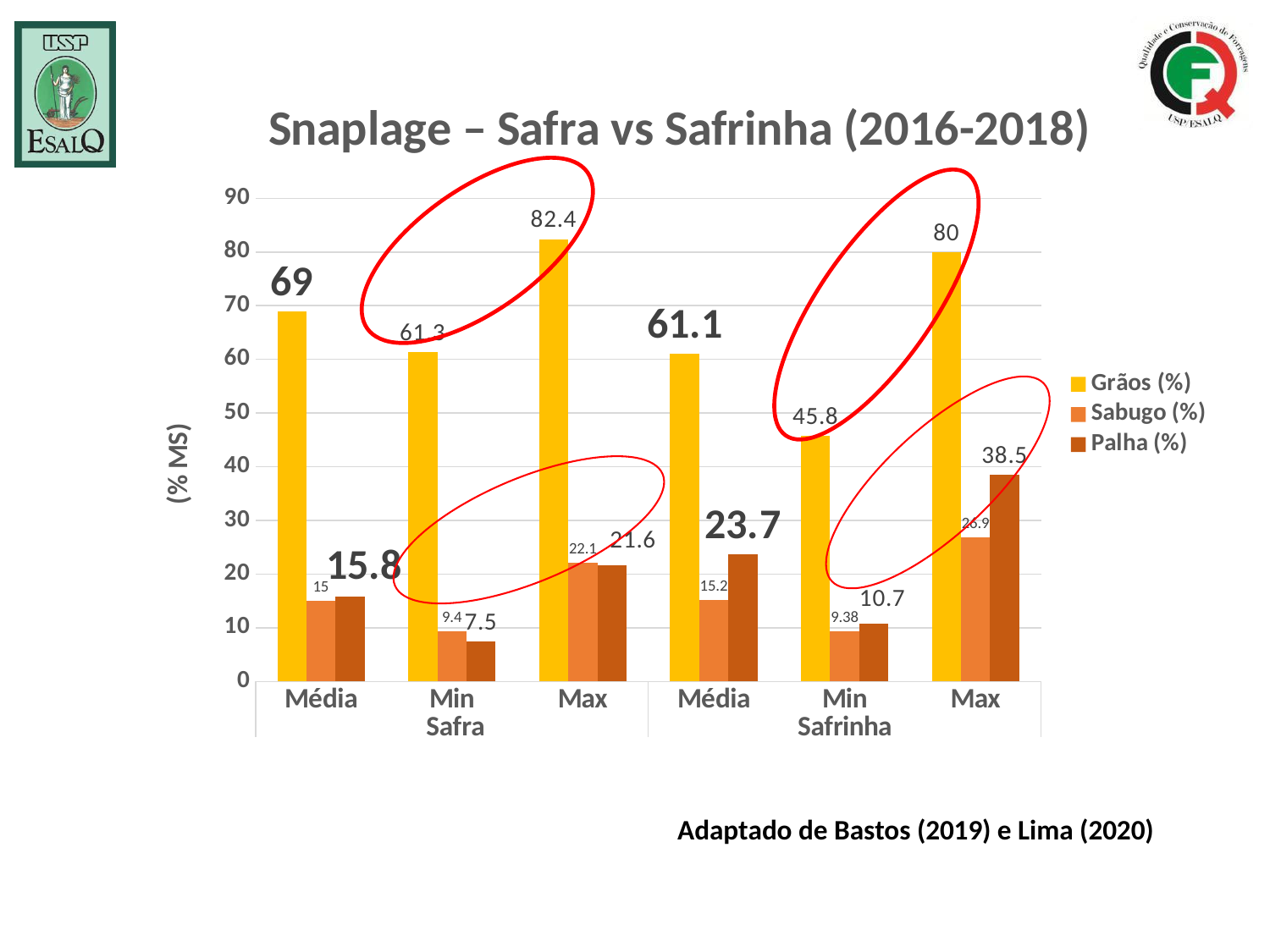
What kind of chart is shown on the slide? Bar chart What is the Sabugo (%) value for Min in Safrinha? 9.38 How many series does the legend list? 3 Which category has the lowest Palha (%) value? Min (Safra) What is the label on the vertical axis? (% MS) What is the Grãos (%) value for Max in Safra? 82.4 What is the difference between the Grãos (%) values for Média in Safra and Média in Safrinha? 7.9 What is the Grãos (%) value for Média in Safrinha? 61.1 Which is larger, the Palha (%) value for Max in Safra or for Max in Safrinha? Max in Safrinha Which category has the highest Grãos (%) value? Max (Safra) What is the Palha (%) value for Max in Safrinha? 38.5 What is the title of the chart? Snaplage – Safra vs Safrinha (2016-2018)